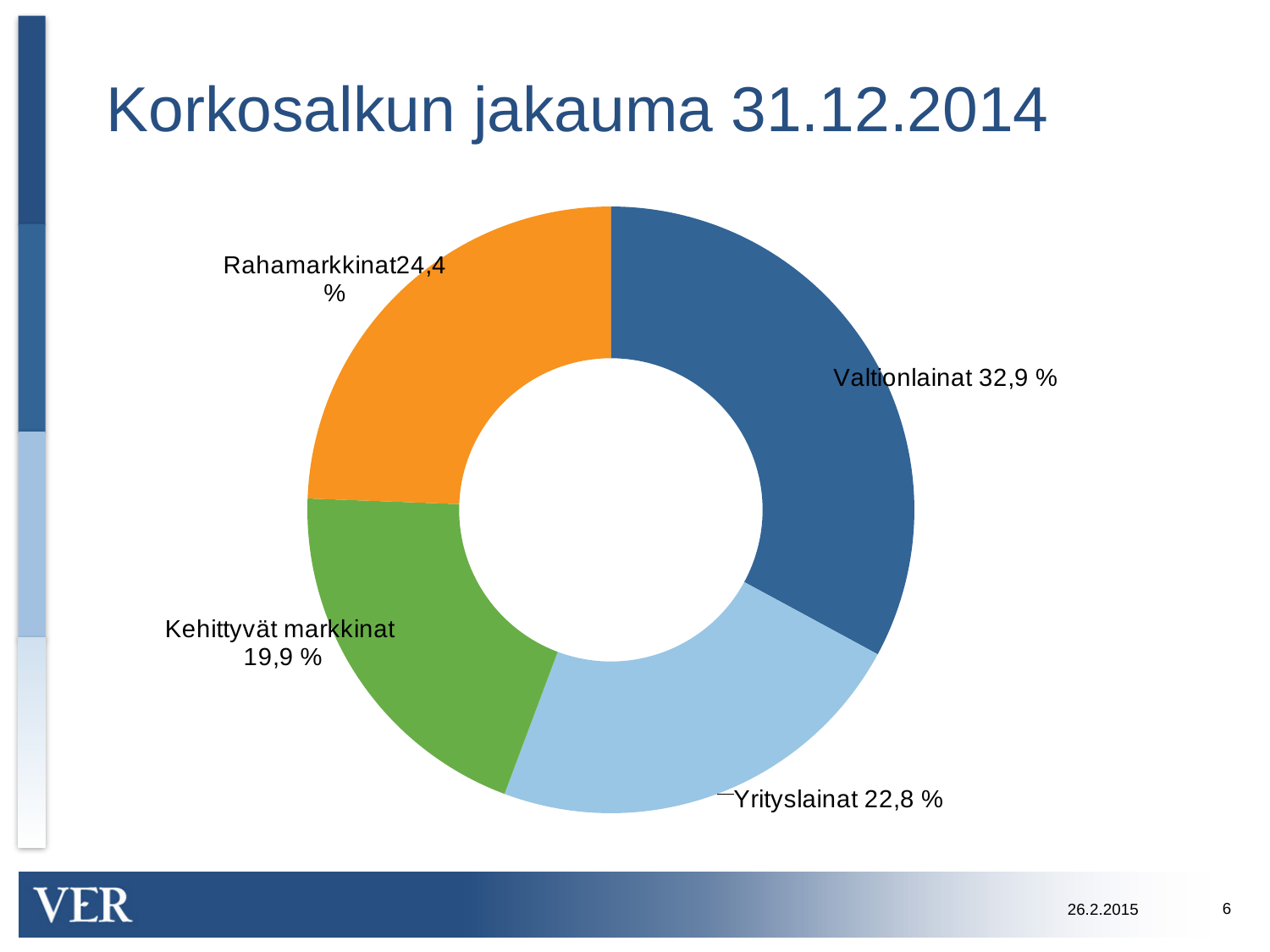
What share of the portfolio is Kehittyvät markkinat? 19,9 % Which category has the largest share? Valtionlainat What share of the portfolio is Rahamarkkinat? 24,4 % What is the difference in percentage points between Valtionlainat and Kehittyvät markkinat? 13,0 Which is larger, the share of Rahamarkkinat or the share of Yrityslainat? Rahamarkkinat What is the title of the chart? Korkosalkun jakauma 31.12.2014 What share of the portfolio is Yrityslainat? 22,8 % What kind of chart is shown on the slide? Doughnut (pie) chart What share of the portfolio is Valtionlainat? 32,9 % How many categories are shown in the chart? 4 Which category has the smallest share? Kehittyvät markkinat What is the difference in percentage points between Rahamarkkinat and Yrityslainat? 1,6